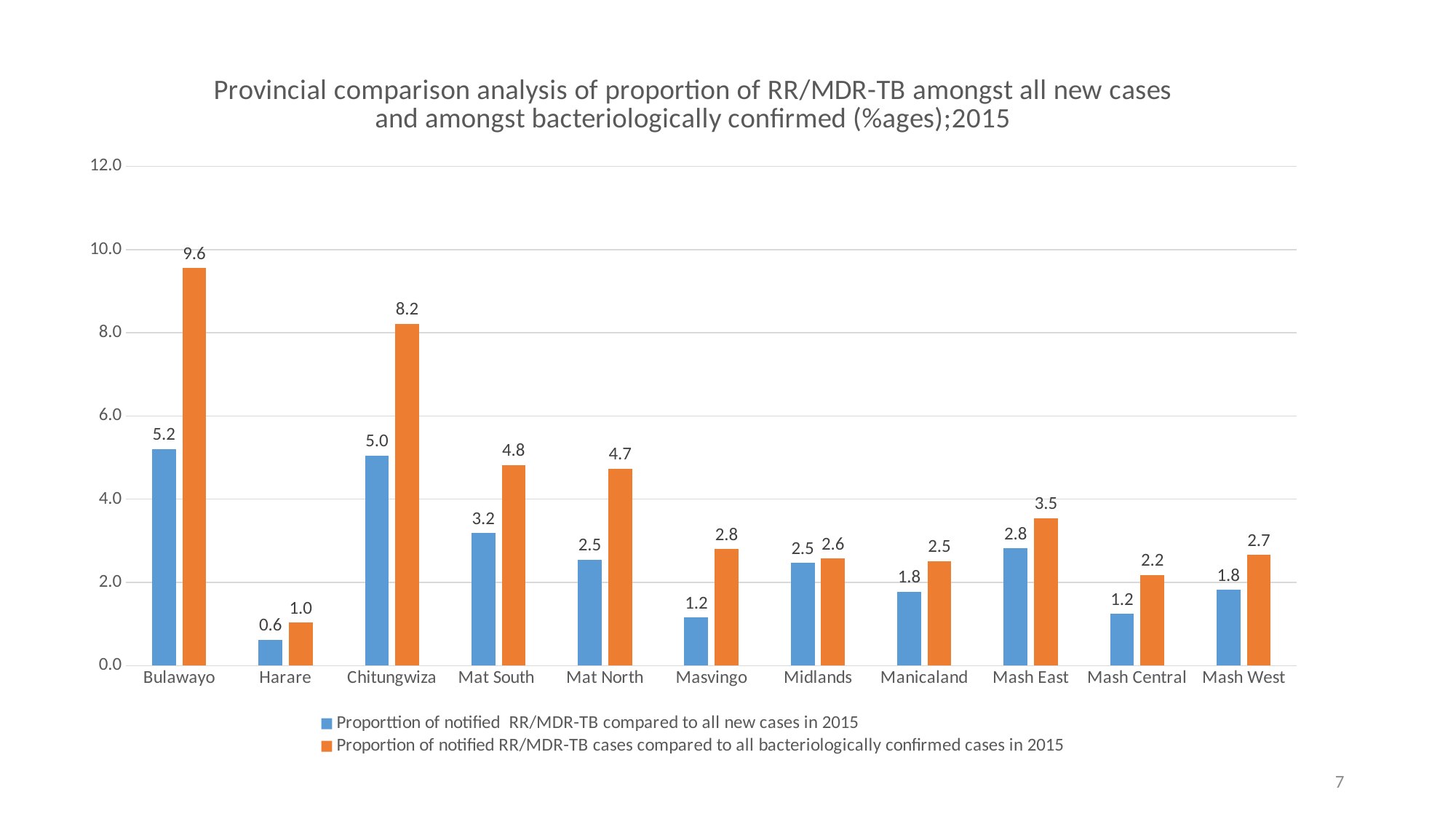
How many series does the legend list? 2 What is the difference between the bacteriologically confirmed proportion and the all new cases proportion for Bulawayo? 4.4 What is the proportion of notified RR/MDR-TB cases compared to all bacteriologically confirmed cases in 2015 for Chitungwiza? 8.2 What is the value for Mash Central in the series for all new cases in 2015? 1.2 How many provinces are shown on the x axis of the chart? 11 What colour are the bars for the proportion of notified RR/MDR-TB compared to all new cases in 2015? Blue Which is larger for Mat South: the proportion compared to all new cases or the proportion compared to all bacteriologically confirmed cases? Proportion compared to all bacteriologically confirmed cases What is the proportion of notified RR/MDR-TB compared to all new cases in 2015 for Bulawayo? 5.2 What kind of chart is shown on the slide? Bar chart Which province has the highest proportion of notified RR/MDR-TB cases compared to all bacteriologically confirmed cases in 2015? Bulawayo Is the value for Chitungwiza in the bacteriologically confirmed series greater or less than 6.0? greater Which province has the lowest proportion of notified RR/MDR-TB compared to all new cases in 2015? Harare